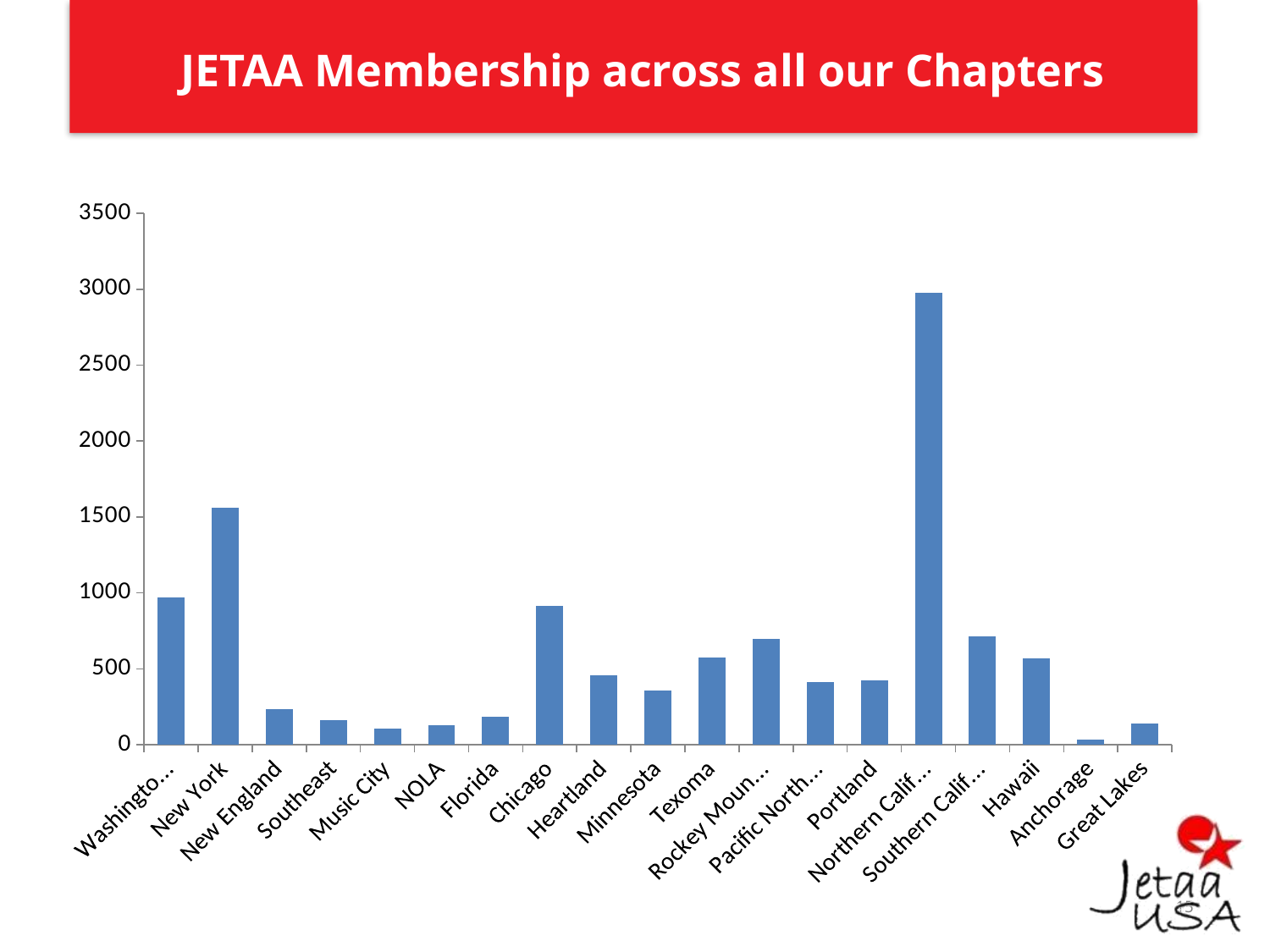
Which has the larger membership, New York or Chicago? New York Is the value for New York greater or less than 1500? greater How many chapters are shown on the x axis of the chart? 19 Which chapter has the highest membership in the chart? Northern Calif... What is the title of the chart? JETAA Membership across all our Chapters What kind of chart is shown on the slide? bar chart Is the value for Hawaii greater or less than 500? greater Is the value for Chicago greater or less than 1000? less Which has the larger membership, Hawaii or Great Lakes? Hawaii Which chapter has the lowest membership in the chart? Anchorage